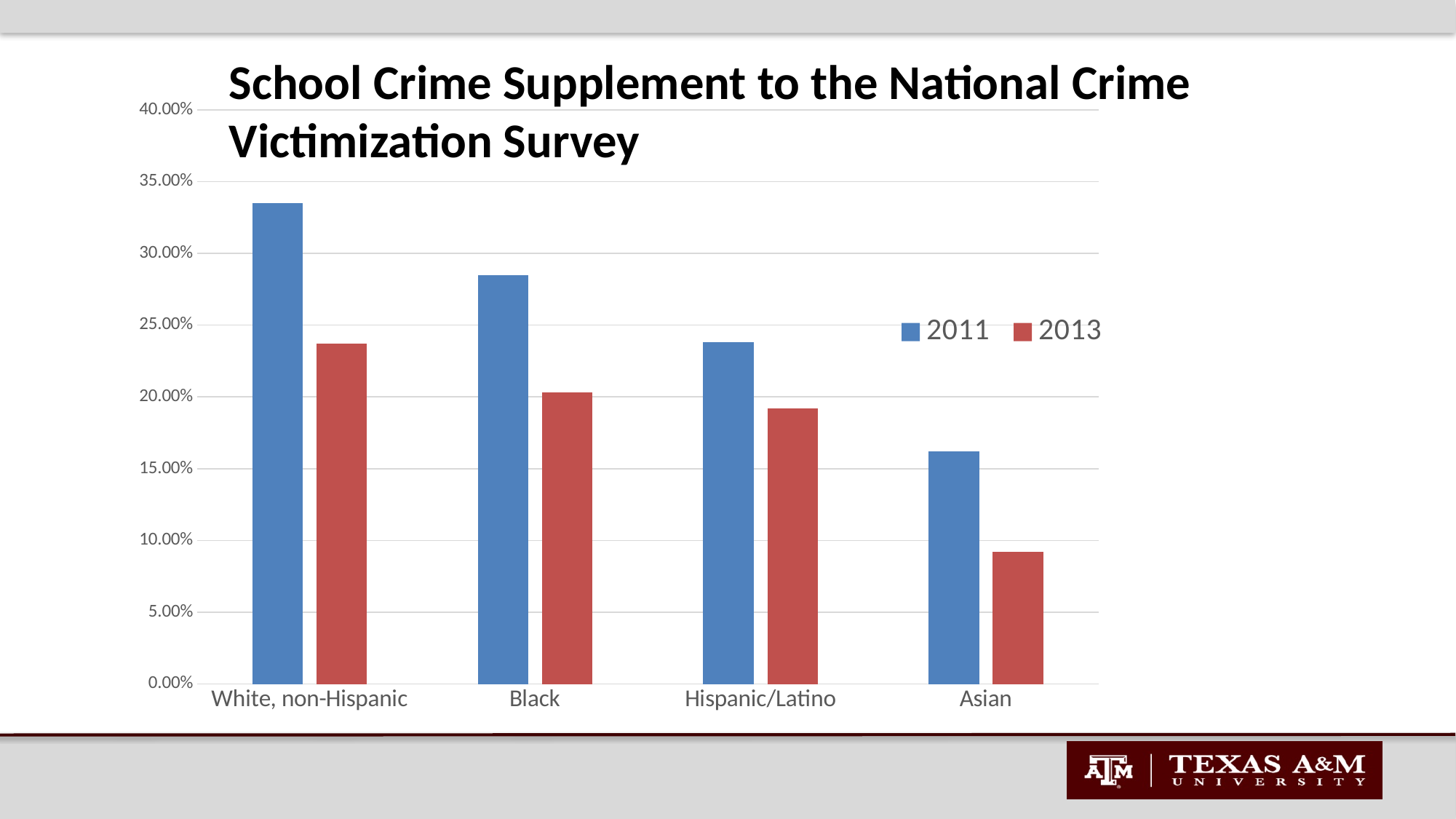
Which category has the highest value for 2011? White, non-Hispanic Is the 2011 value for White, non-Hispanic greater or less than 30.00%? greater Is the 2013 value for Asian greater or less than 10.00%? less Which category has the lowest value for 2013? Asian Which category has the lowest value for 2011? Asian How many series does the legend list? 2 How many categories are shown on the x axis? 4 Do the 2011 values rise or fall moving from left to right across the categories? fall What kind of chart is shown on the slide? bar chart For Hispanic/Latino, which year has the larger value, 2011 or 2013? 2011 Which colour represents the 2013 series in the legend? red